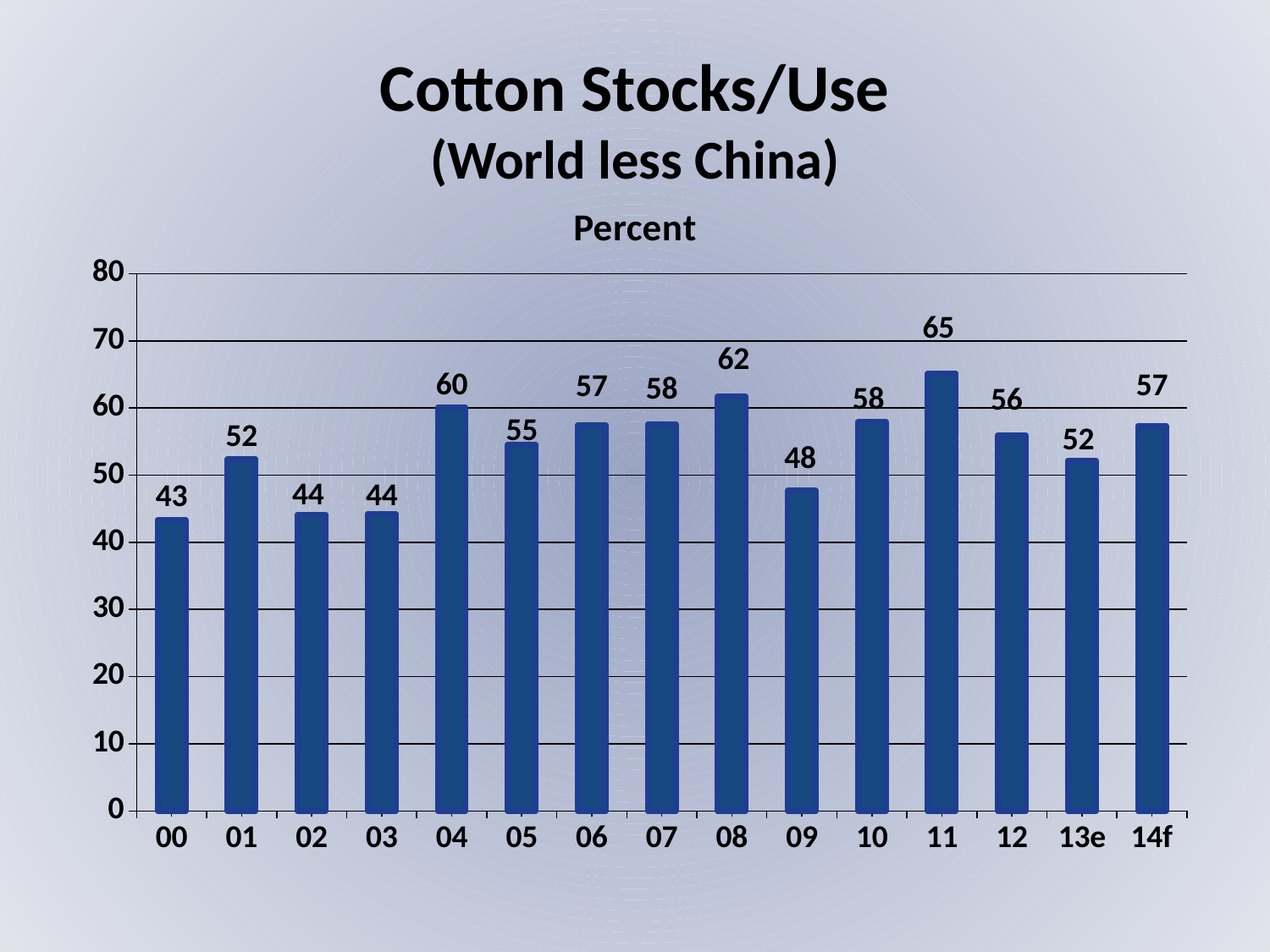
What is the difference between the values for 11 and 00? 22 How many years are shown on the x axis? 15 Which is larger, the value for 04 or the value for 05? 04 What is the title of the chart? Cotton Stocks/Use (World less China) What is the value for 04? 60 Which year has the lowest value? 00 What is the value for 14f? 57 What is the value for 09? 48 Is the value for 11 greater or less than 60? greater What is the difference between the values for 08 and 09? 14 Which year has the highest value? 11 What kind of chart is this? bar chart